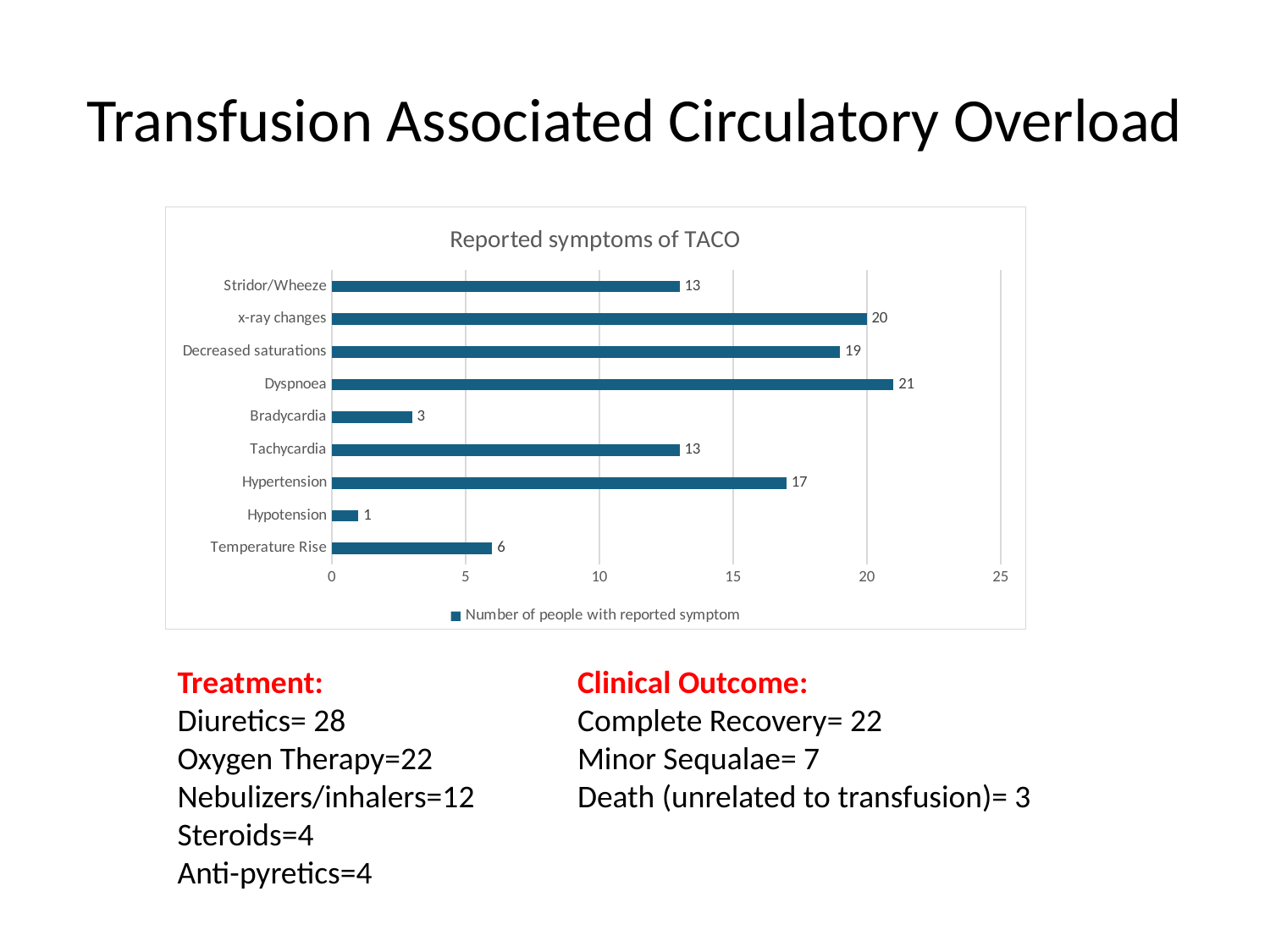
How many symptom categories are shown in the chart? 9 What kind of chart is shown on the slide? bar chart Which symptom has the highest number of people reporting it? Dyspnoea What is the number of people with reported symptom for Hypertension? 17 What is the number of people with reported symptom for Hypotension? 1 Which is larger, the value for Decreased saturations or the value for Tachycardia? Decreased saturations Which symptom has the lowest number of people reporting it? Hypotension What is the difference between the values for x-ray changes and Temperature Rise? 14 What is the title of the chart? Reported symptoms of TACO Is the value for Bradycardia greater or less than 5? less How many series does the chart legend list? 1 What is the number of people with reported symptom for Dyspnoea? 21